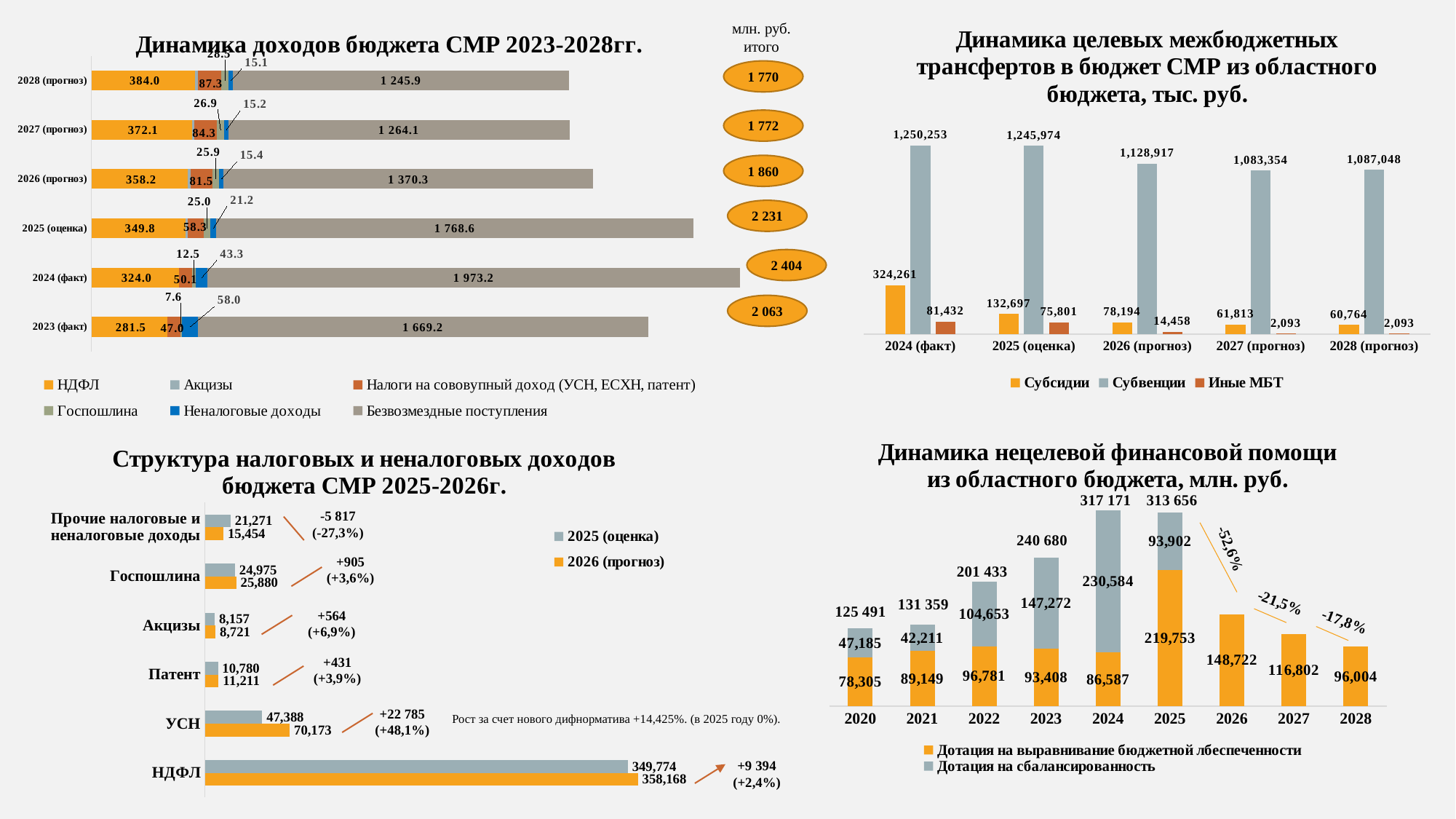
In the chart 'Динамика нецелевой финансовой помощи из областного бюджета, млн. руб.', what is the total of the stacked bar for 2024? 317 171 In the chart 'Динамика доходов бюджета СМР 2023-2028гг.', which year has the highest value for Безвозмездные поступления? 2024 (факт) In the chart 'Структура налоговых и неналоговых доходов бюджета СМР 2025-2026г.', what is the value of УСН for 2026 (прогноз)? 70,173 In the chart 'Динамика целевых межбюджетных трансфертов в бюджет СМР из областного бюджета, тыс. руб.', what is the difference between Субсидии in 2024 (факт) and 2025 (оценка)? 191,564 In the chart 'Динамика целевых межбюджетных трансфертов в бюджет СМР из областного бюджета, тыс. руб.', which year has the lowest value for Субсидии? 2028 (прогноз) In the chart 'Структура налоговых и неналоговых доходов бюджета СМР 2025-2026г.', which is larger for Прочие налоговые и неналоговые доходы: 2025 (оценка) or 2026 (прогноз)? 2025 (оценка) How many series does the legend of the chart 'Динамика доходов бюджета СМР 2023-2028гг.' list? 6 How many categories are shown on the x axis of the chart 'Динамика нецелевой финансовой помощи из областного бюджета, млн. руб.'? 9 In the chart 'Динамика нецелевой финансовой помощи из областного бюджета, млн. руб.', what is the value of Дотация на сбалансированность for 2023? 147,272 What kind of chart is 'Структура налоговых и неналоговых доходов бюджета СМР 2025-2026г.'? bar chart In the chart 'Динамика целевых межбюджетных трансфертов в бюджет СМР из областного бюджета, тыс. руб.', what is the value of Субвенции for 2026 (прогноз)? 1,128,917 In the chart 'Динамика доходов бюджета СМР 2023-2028гг.', what is the value of НДФЛ for 2028 (прогноз)? 384.0